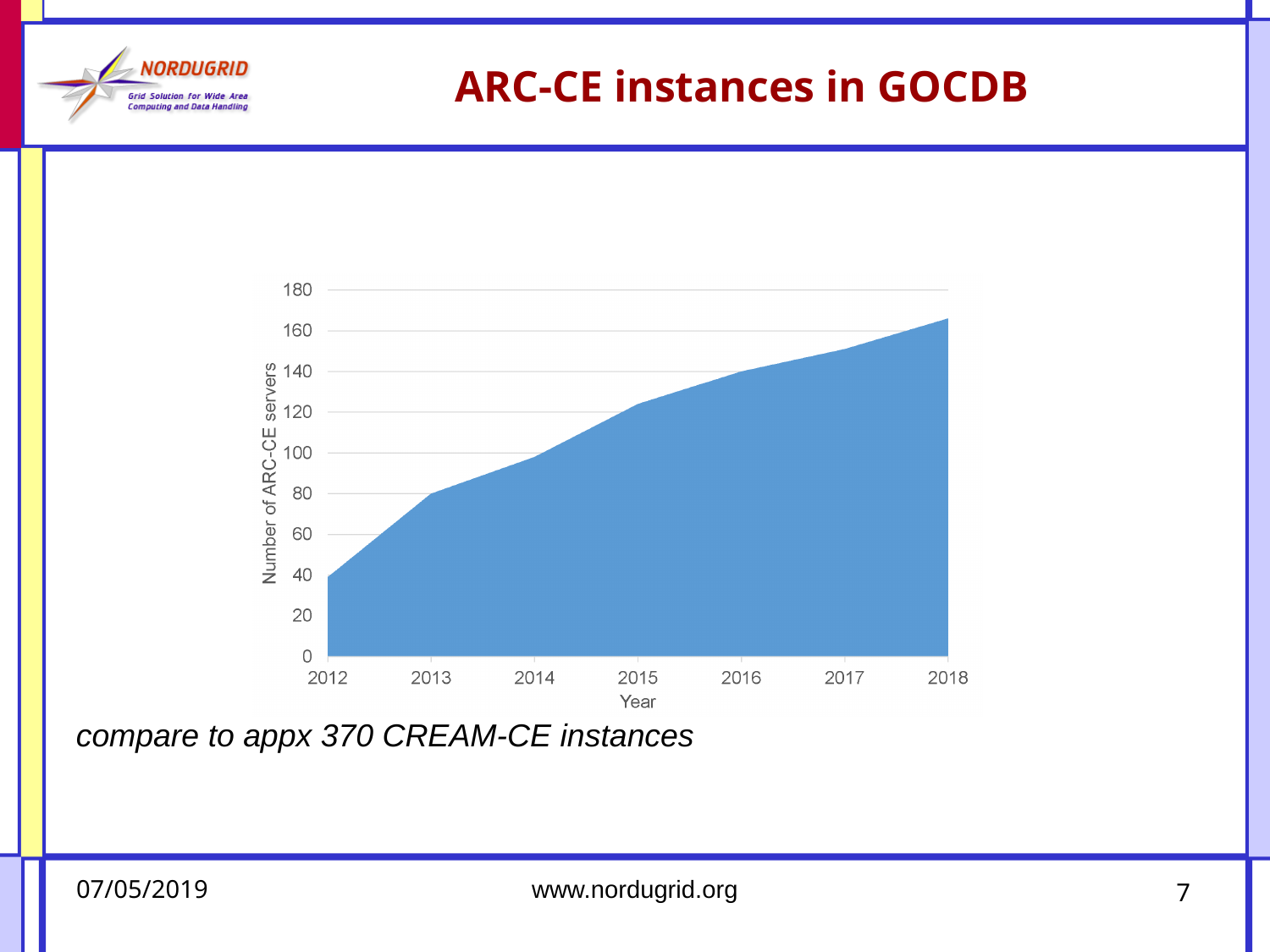
What kind of chart is shown on the slide? area chart Which year has the highest number of ARC-CE servers? 2018 What is the label of the y axis of the chart? Number of ARC-CE servers Do the values rise or fall from 2012 to 2018? rise Is the value for 2014 greater or less than 120? less How many years are marked on the x axis of the chart? 7 Is the value for 2012 greater or less than 60? less Which year has the lowest number of ARC-CE servers? 2012 Which year has more ARC-CE servers, 2013 or 2016? 2016 Is the value for 2018 greater or less than 160? greater What is the title of the chart on the slide? ARC-CE instances in GOCDB